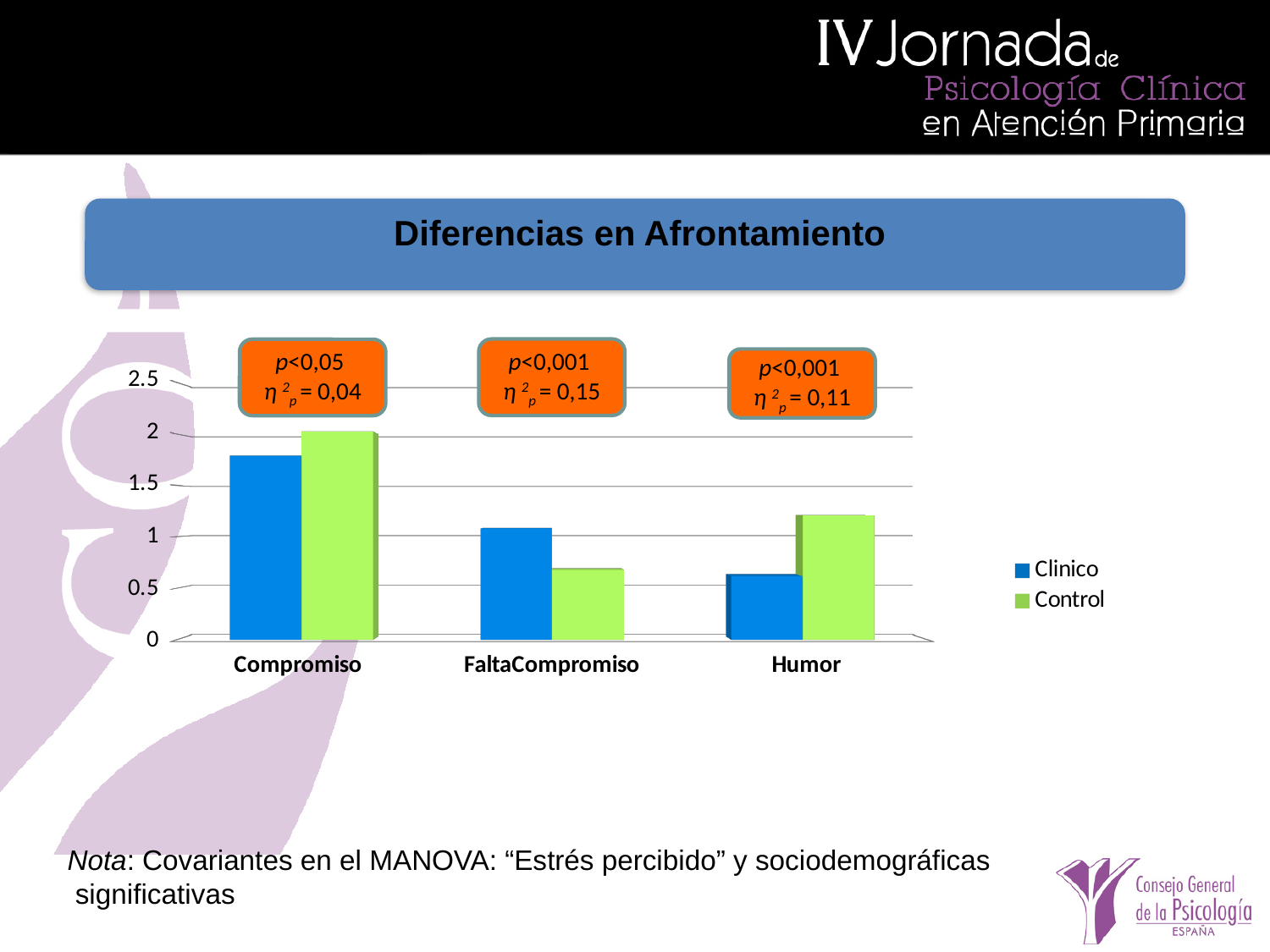
Is the Control value for Humor greater or less than 1.5? less Which series has the higher value for FaltaCompromiso, Clinico or Control? Clinico For the Control series, which category has the lowest value? FaltaCompromiso Which series has the higher value for Humor, Clinico or Control? Control For the Clinico series, which category has the lowest value? Humor How many categories are shown on the x axis of the chart? 3 For the Clinico series, which category has the highest value? Compromiso Is the Clinico value for Compromiso greater or less than 1.5? greater Which series has the higher value for Compromiso, Clinico or Control? Control What kind of chart is shown on the slide? bar chart What is the title shown above the chart? Diferencias en Afrontamiento How many series does the chart legend list? 2